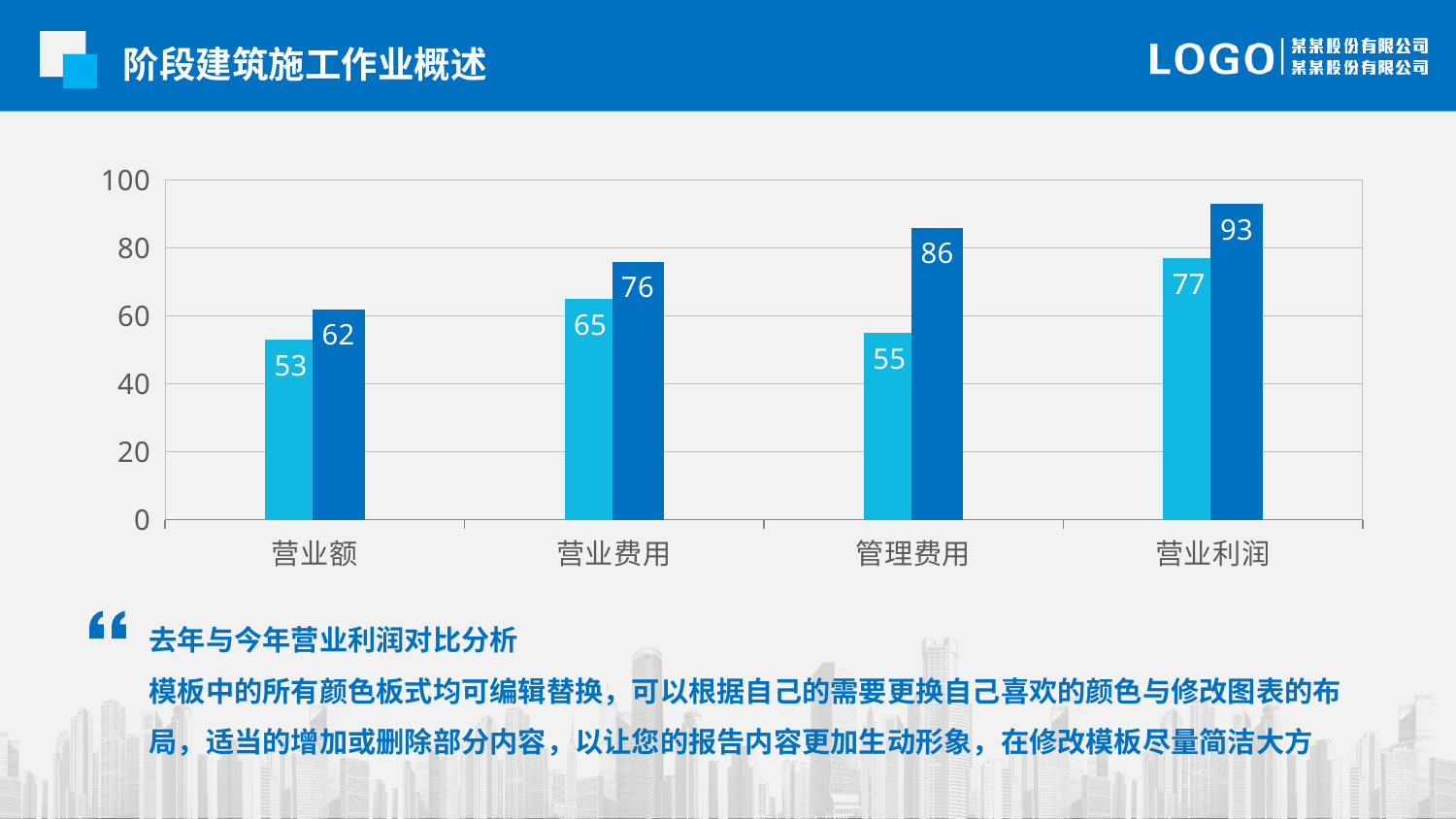
What is the value of the light blue bar for 营业额? 53 What is the value of the dark blue bar for 营业利润? 93 Do the dark blue bars rise or fall from 营业额 to 营业利润? rise Which is larger for 营业费用, the light blue bar or the dark blue bar? the dark blue bar Which category has the lowest light blue bar? 营业额 What is the difference between the dark blue and light blue bars for 管理费用? 31 Is the light blue bar for 营业利润 greater or less than 60? greater What is the value of the dark blue bar for 管理费用? 86 How many categories are shown on the x axis? 4 What kind of chart is shown on the slide? bar chart Which category has the highest dark blue bar? 营业利润 What is the difference between the dark blue bars for 营业利润 and 营业额? 31